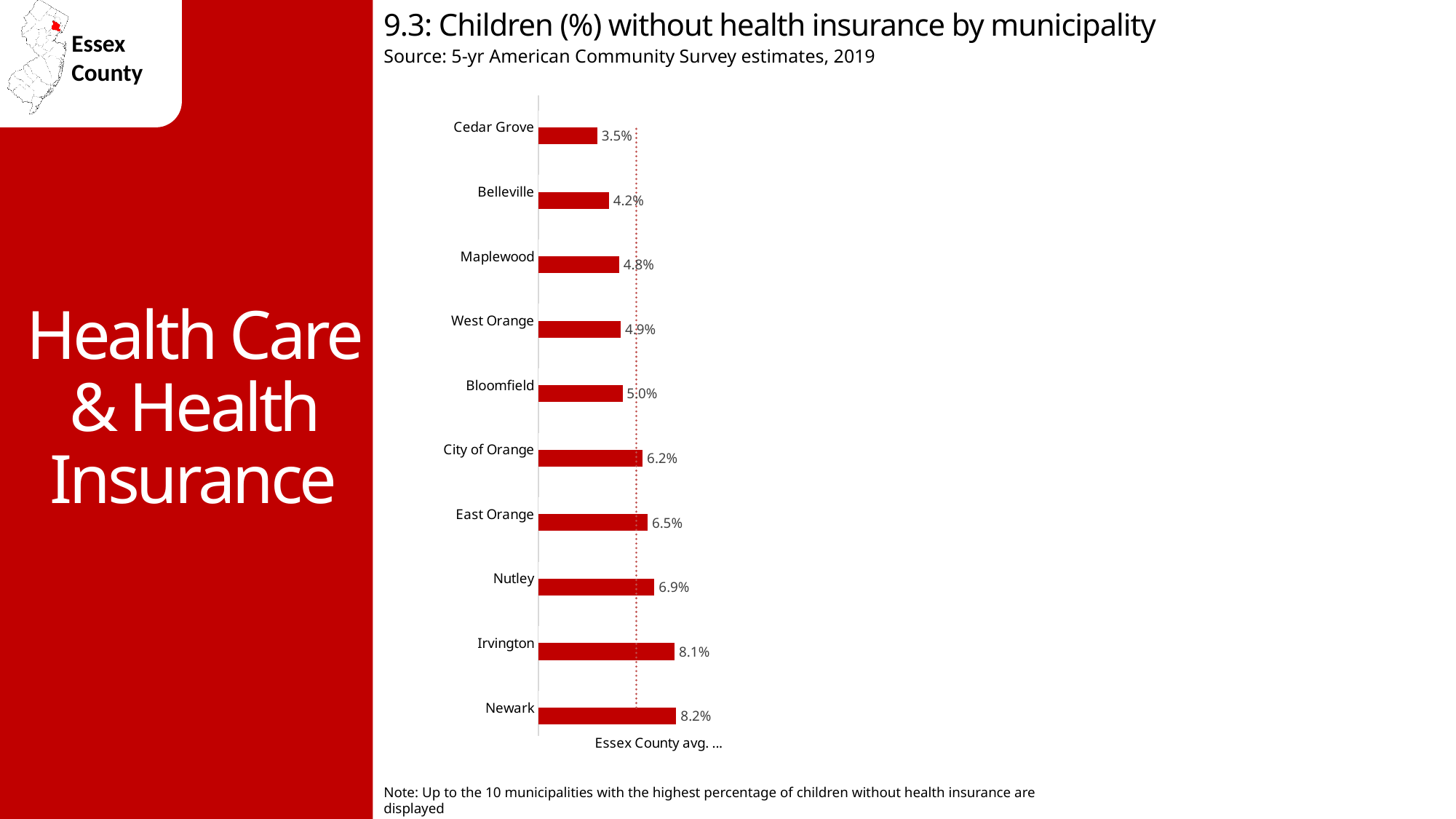
Which municipality has the lowest percentage of children without health insurance? Cedar Grove What is the difference between the values for Newark and Cedar Grove? 4.7% What is the title of the chart? 9.3: Children (%) without health insurance by municipality What kind of chart is shown on the slide? Bar chart How many municipalities are shown in the chart? 10 What is the difference between the values for Nutley and Belleville? 2.7% Which municipality has the highest percentage of children without health insurance? Newark What is the value for Bloomfield? 5.0% What percentage of children in Cedar Grove are without health insurance? 3.5% What is the value shown for Newark? 8.2% Which has a higher percentage of children without health insurance, Maplewood or City of Orange? City of Orange What percentage is shown for East Orange? 6.5%